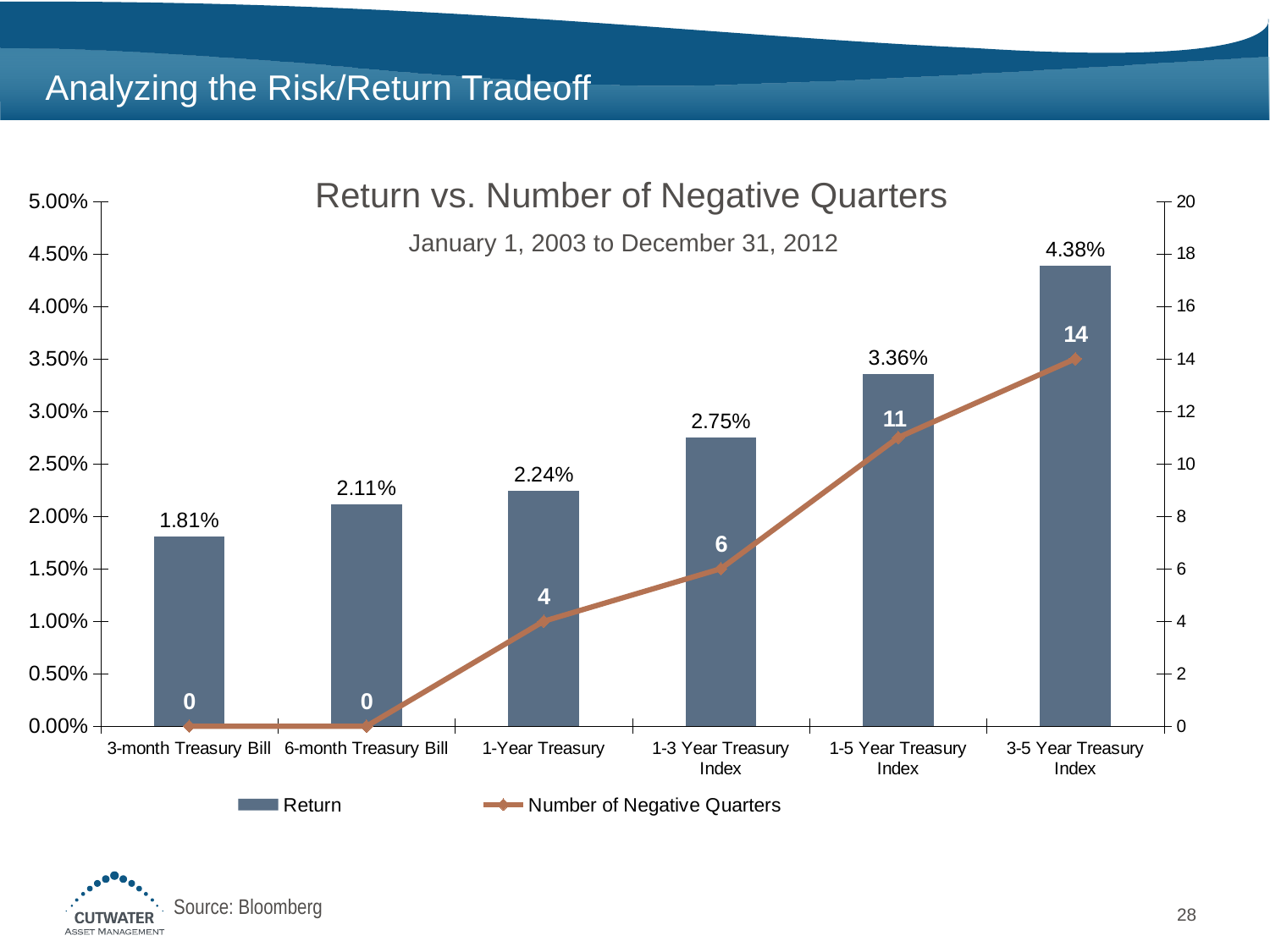
Which category has the lowest Return? 3-month Treasury Bill What is the Number of Negative Quarters for the 1-5 Year Treasury Index? 11 What is the Return for the 1-3 Year Treasury Index? 2.75% Does the Number of Negative Quarters rise or fall from left to right along the x axis? Rise How many series does the legend list? 2 Which has a higher Return, the 6-month Treasury Bill or the 1-Year Treasury? 1-Year Treasury Which category has the highest Return? 3-5 Year Treasury Index What is the title of the chart? Return vs. Number of Negative Quarters What is the difference in Return between the 3-5 Year Treasury Index and the 1-5 Year Treasury Index? 1.02% What is the Return for the 3-month Treasury Bill? 1.81% How many categories are shown on the x axis? 6 What kind of chart is used to show the Return series? Bar chart